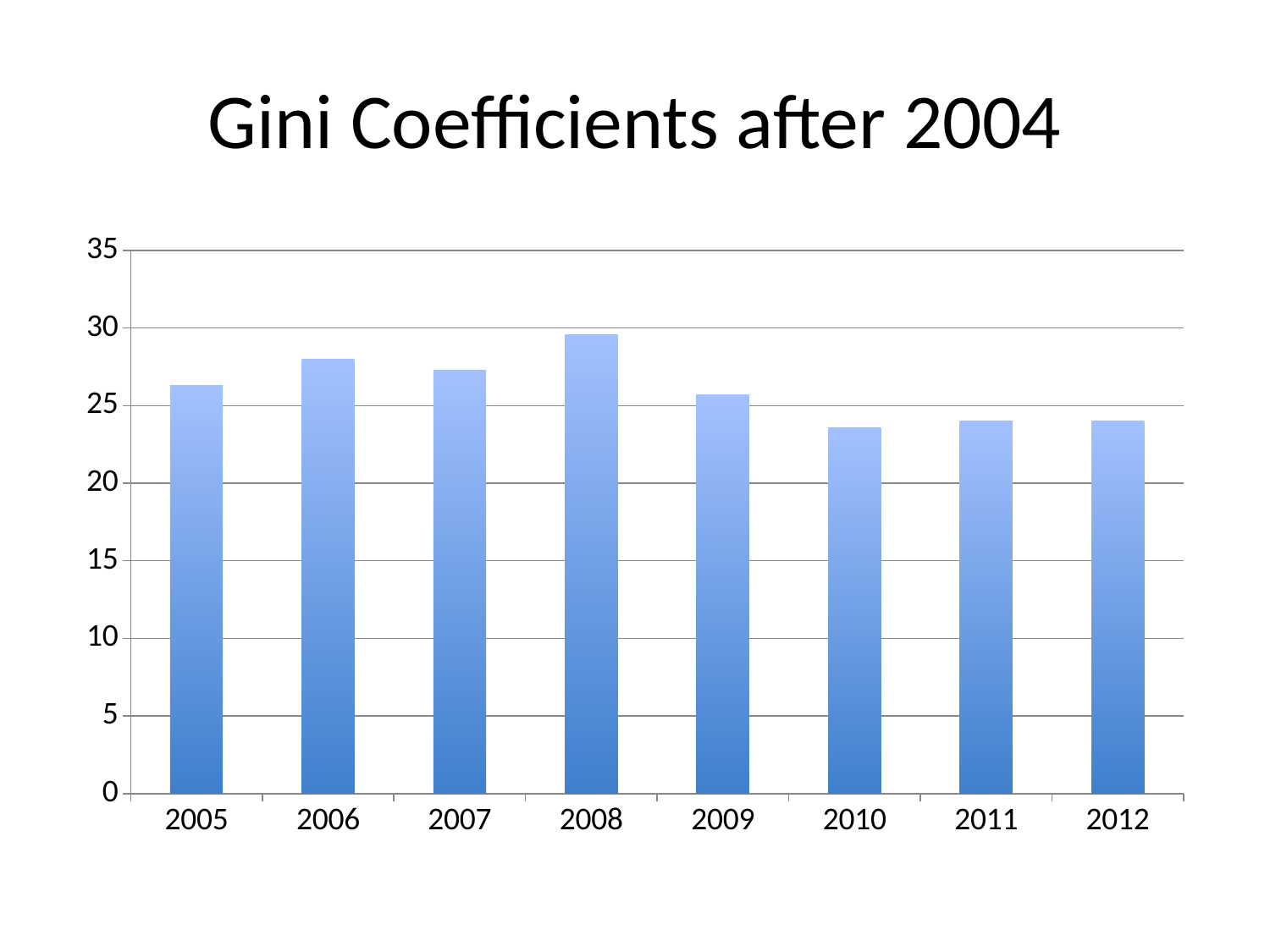
Which is larger, the value for 2010 or the value for 2005? 2005 Which year has the highest Gini coefficient? 2008 Is the value for 2006 greater or less than 30? less Is the value for 2008 greater or less than 25? greater Which is larger, the value for 2008 or the value for 2005? 2008 What is the title of the chart? Gini Coefficients after 2004 What kind of chart is shown on the slide? bar chart Which is larger, the value for 2006 or the value for 2009? 2006 Do the values rise or fall from 2008 to 2010? fall Is the value for 2010 greater or less than 25? less How many years are shown on the x axis of the chart? 8